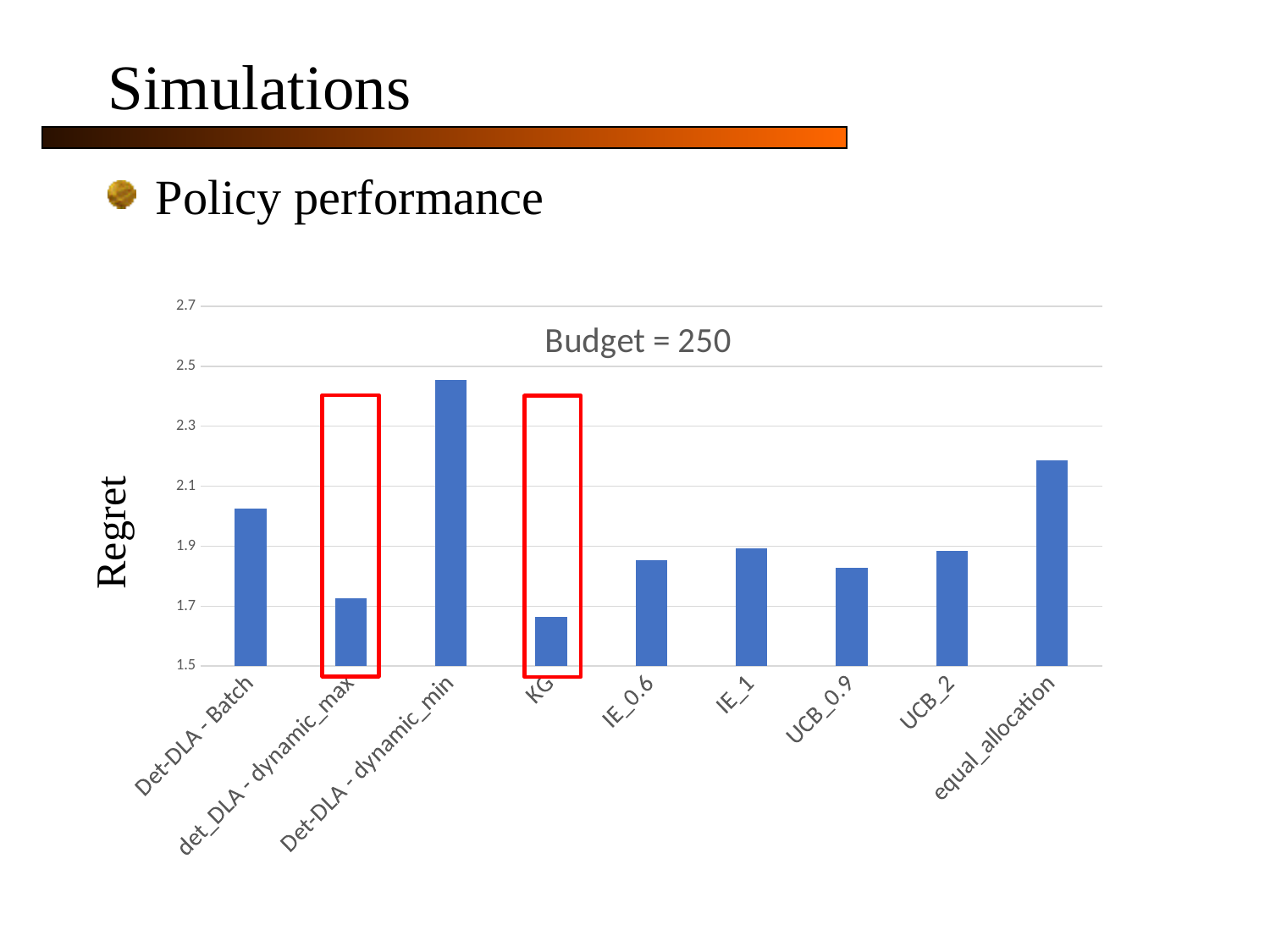
Is the regret for Det-DLA - dynamic_min greater or less than 2.3? greater Is the regret for equal_allocation greater or less than 2.1? greater Is the regret for Det-DLA - Batch greater or less than 2.1? less What is the title shown inside the chart? Budget = 250 Which policy has the lowest regret in the chart? KG How many categories (policies) are plotted on the x axis of the chart? 9 What is the label on the vertical axis of the chart? Regret Which policy has the highest regret in the chart? Det-DLA - dynamic_min Which has the lower regret, equal_allocation or IE_1? IE_1 What kind of chart is shown on the slide? bar chart Which has the higher regret, Det-DLA - Batch or det_DLA - dynamic_max? Det-DLA - Batch